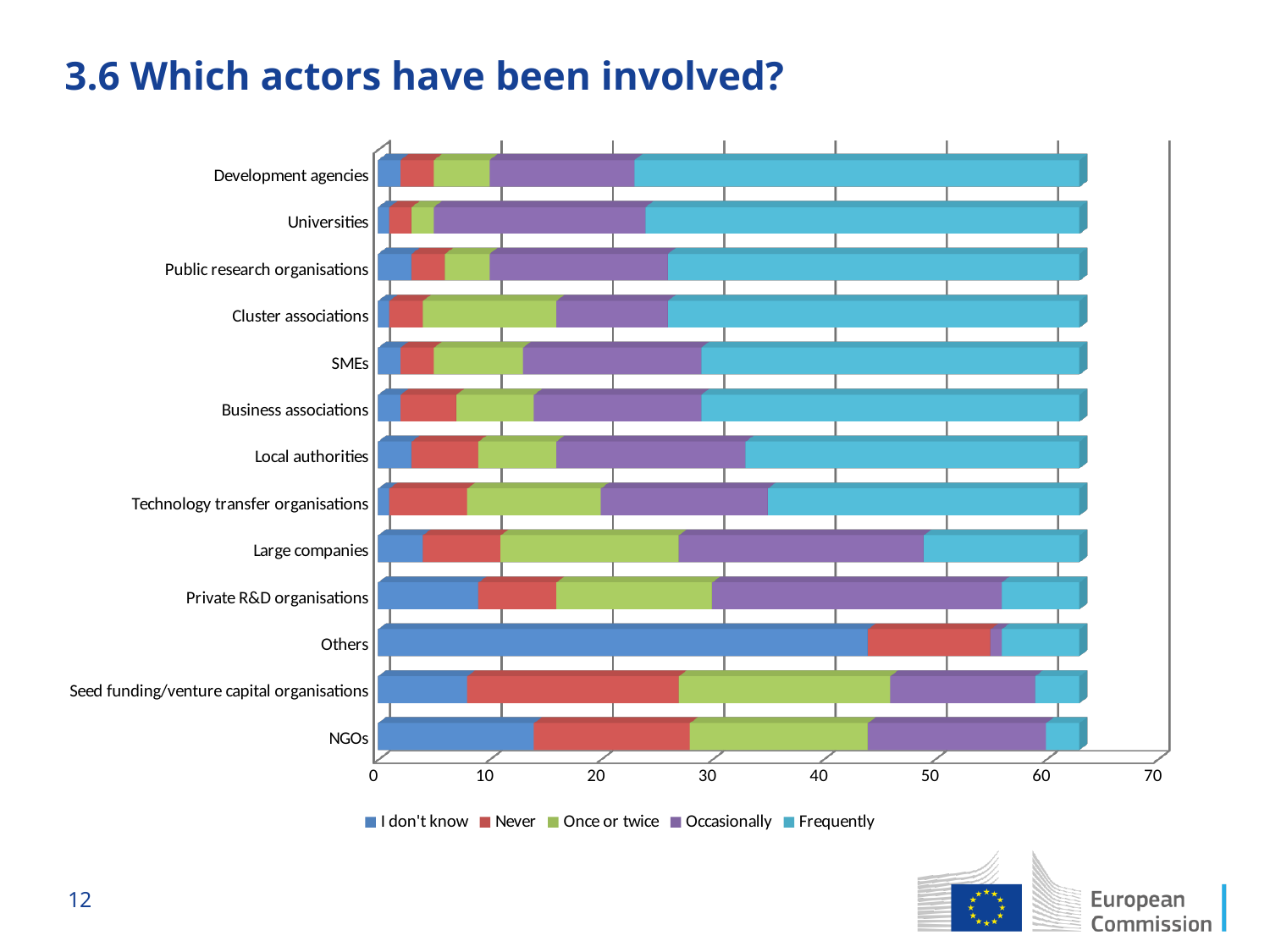
How many series does the legend list? 5 What kind of chart is shown on the slide? Stacked bar chart Which category appears at the top of the chart? Development agencies Is the 'Frequently' value for Development agencies greater or less than 30? greater Is the 'Never' segment larger for NGOs or for Universities? NGOs What are the five series named in the legend? I don't know, Never, Once or twice, Occasionally, Frequently Which category has the largest 'Occasionally' segment? Private R&D organisations Is the 'I don't know' value for NGOs greater or less than 10? greater Which category has the largest 'I don't know' segment? Others Which category has the largest 'Never' segment? Seed funding/venture capital organisations Is the 'I don't know' value for Others greater or less than 40? greater How many actor categories are listed on the chart? 13